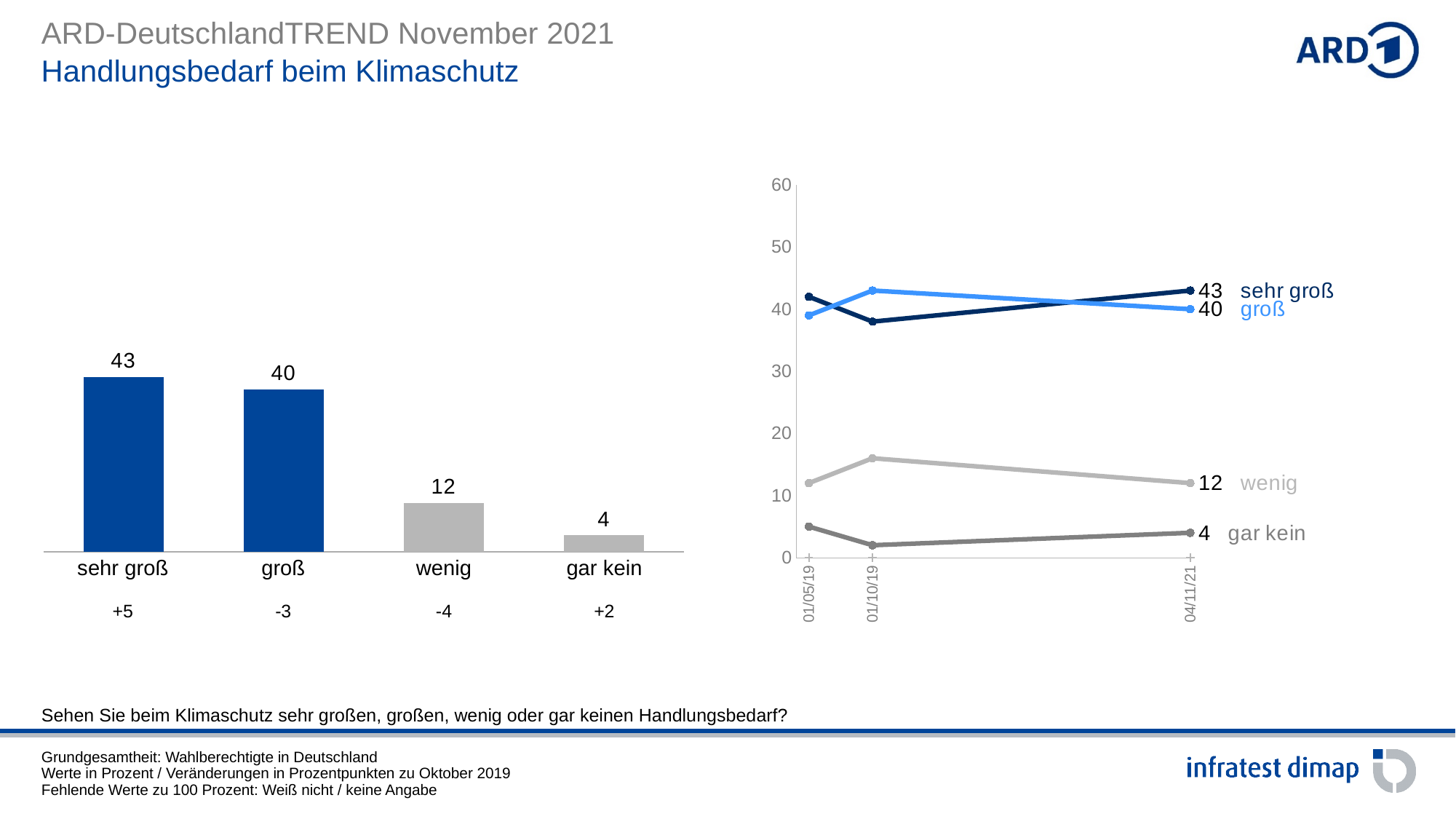
What kind of chart is on the right side of the slide? line chart In the line chart on the right, is the value for "sehr groß" at 01/10/19 greater or less than 40? less In the bar chart on the left, what change in percentage points is shown below "wenig"? -4 In the line chart on the right, what is the value for "groß" at 04/11/21? 40 In the bar chart on the left, what is the value for "sehr groß"? 43 In the bar chart on the left, what is the difference between the values for "sehr groß" and "groß"? 3 In the bar chart on the left, what is the value for "wenig"? 12 In the bar chart on the left, which category has the highest value? sehr groß How many categories does the bar chart on the left show? 4 In the line chart on the right, does the "sehr groß" line rise or fall from 01/10/19 to 04/11/21? rise In the bar chart on the left, which category has the lowest value? gar kein In the line chart on the right, is the value for "wenig" at 01/10/19 greater or less than 10? greater